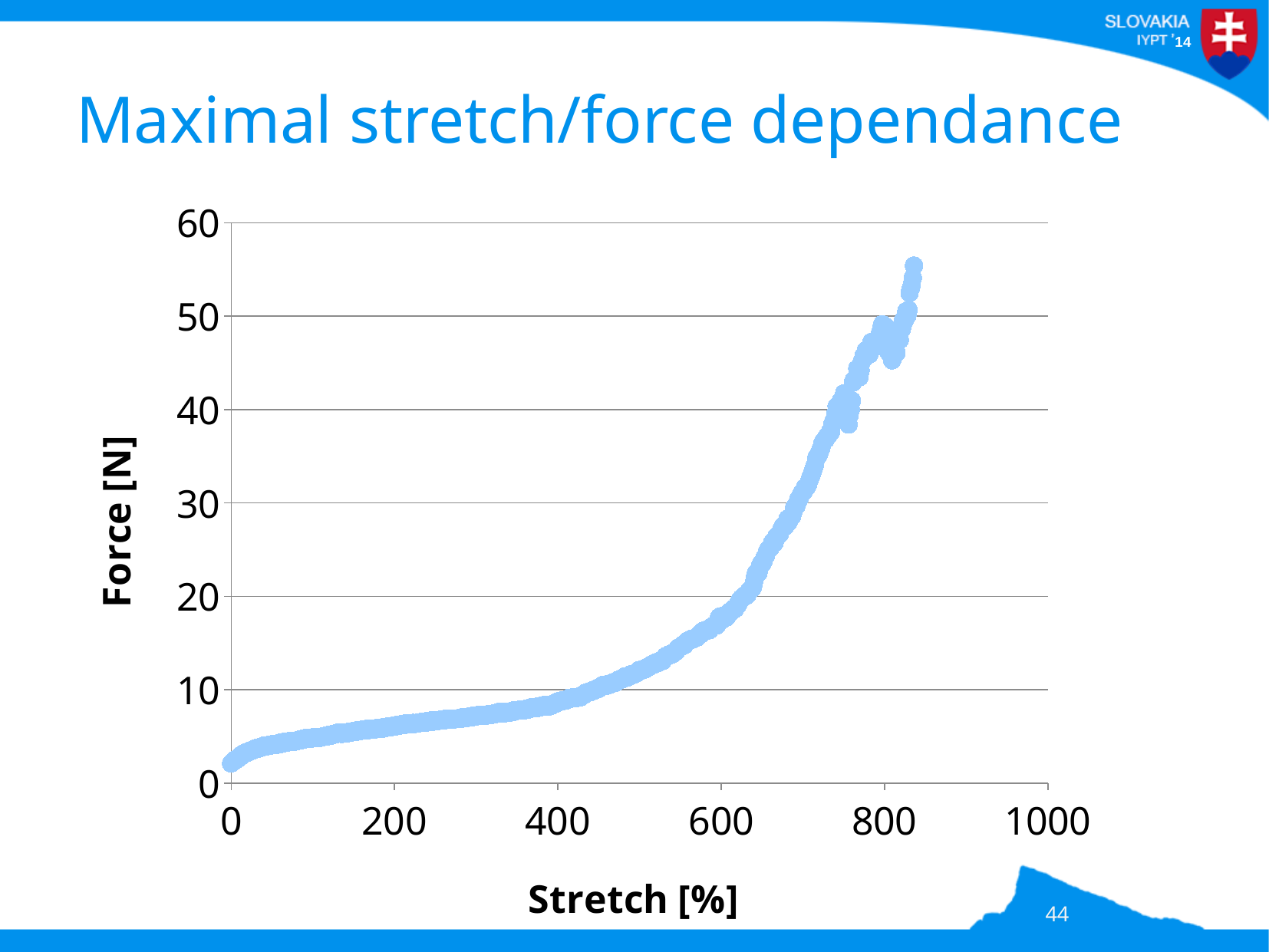
Is the force at a stretch of 800% greater or less than 40 N? greater Is the highest force reached in the chart greater or less than 60 N? less Is the force at a stretch of 600% greater or less than 10 N? greater What kind of chart is shown on the slide? scatter plot Is the force at a stretch of 600% larger or smaller than the force at a stretch of 400%? larger Does the force rise or fall as stretch increases along the x axis? rise What is the title of the chart? Maximal stretch/force dependance What is the label of the vertical axis? Force [N]